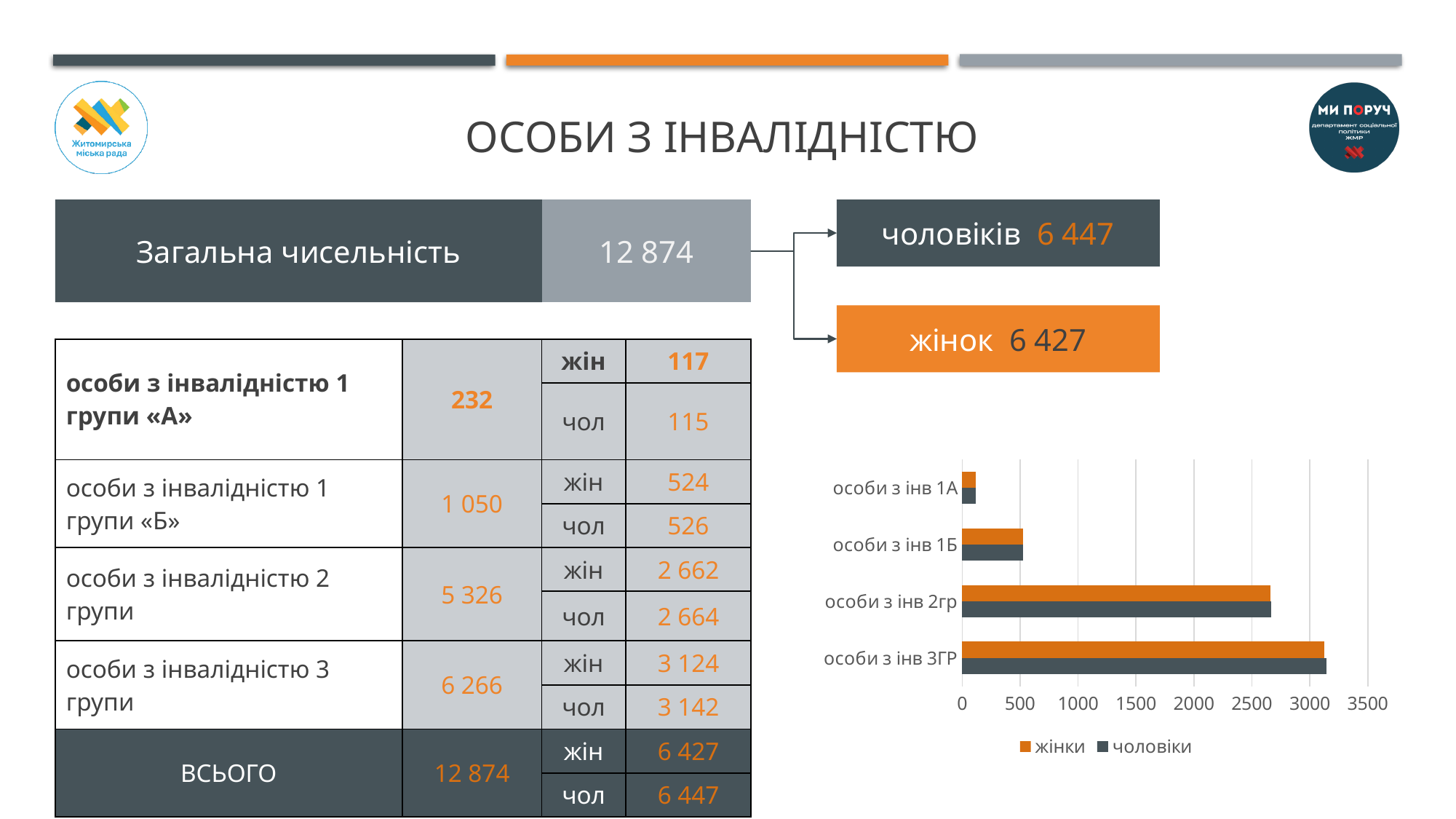
Which category has the longest bars in the chart? особи з інв 3ГР Is the value for жінки in особи з інв 1А greater or less than 500? less Is the value for чоловіки in особи з інв 2гр greater or less than 3000? less Is the value for чоловіки in особи з інв 2гр greater or less than 2500? greater Which category has the shortest bars in the chart? особи з інв 1А What kind of chart is shown on the slide? bar chart How many categories does the bar chart show? 4 What is the highest value shown on the chart's horizontal axis? 3500 Which is larger in the chart: the жінки value for особи з інв 2гр or the жінки value for особи з інв 1Б? особи з інв 2гр What are the two series names listed in the chart legend? жінки, чоловіки How many series does the chart legend list? 2